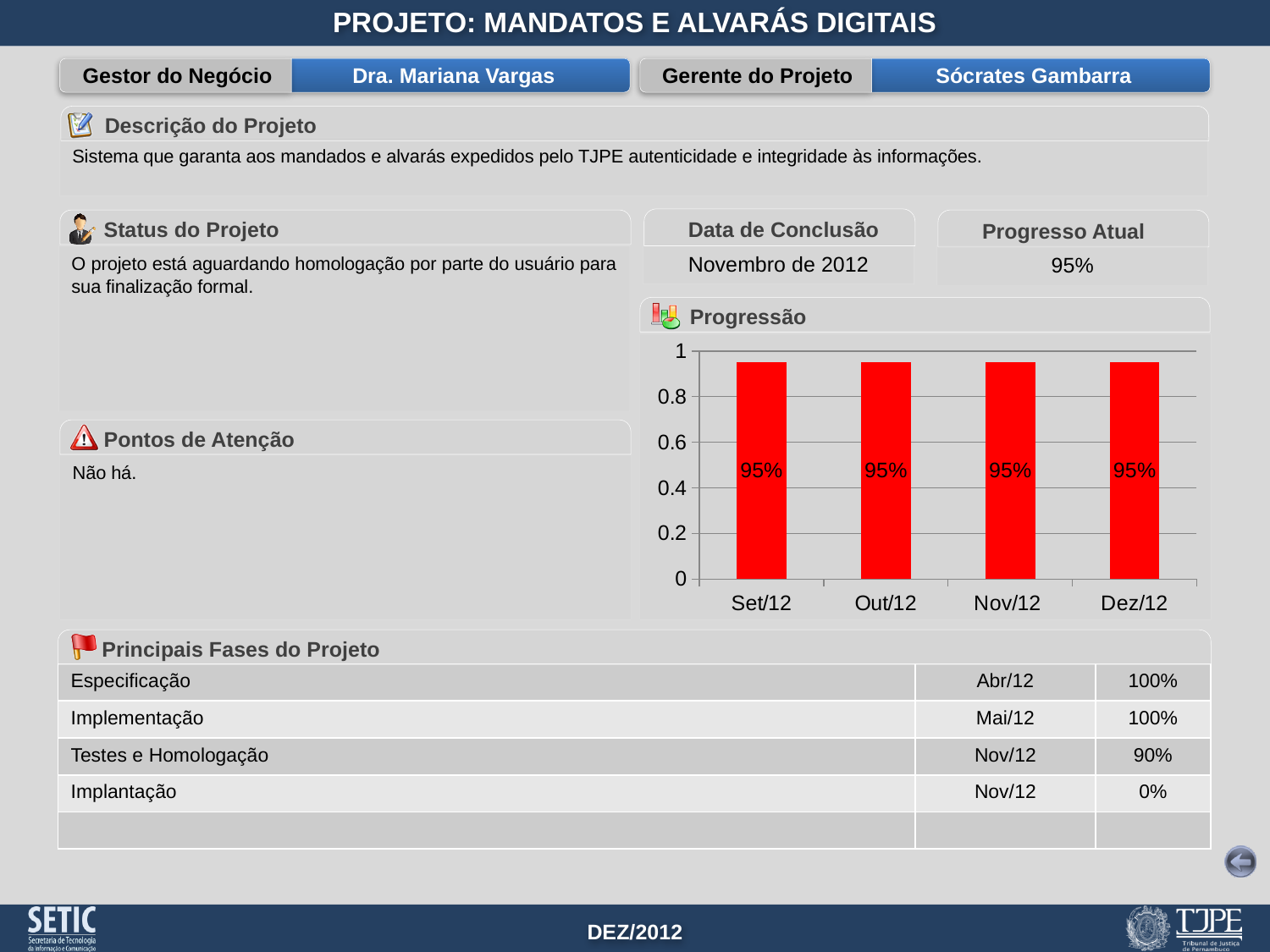
What is the value for Out/12 in the Progressão chart? 95% What is the value for Nov/12 in the Progressão chart? 95% What kind of chart is the Progressão chart? bar chart Is the value for Out/12 in the Progressão chart greater or less than 1? less What is the difference between the values for Set/12 and Dez/12 in the Progressão chart? 0% What colour are the bars in the Progressão chart? red What is the title of the chart on the slide? Progressão How many categories are shown on the x axis of the Progressão chart? 4 Is the value for Nov/12 in the Progressão chart greater or less than 0.8? greater What is the value for Set/12 in the Progressão chart? 95% What is the value for Dez/12 in the Progressão chart? 95% Do the values in the Progressão chart rise, fall, or stay the same from Set/12 to Dez/12? stay the same